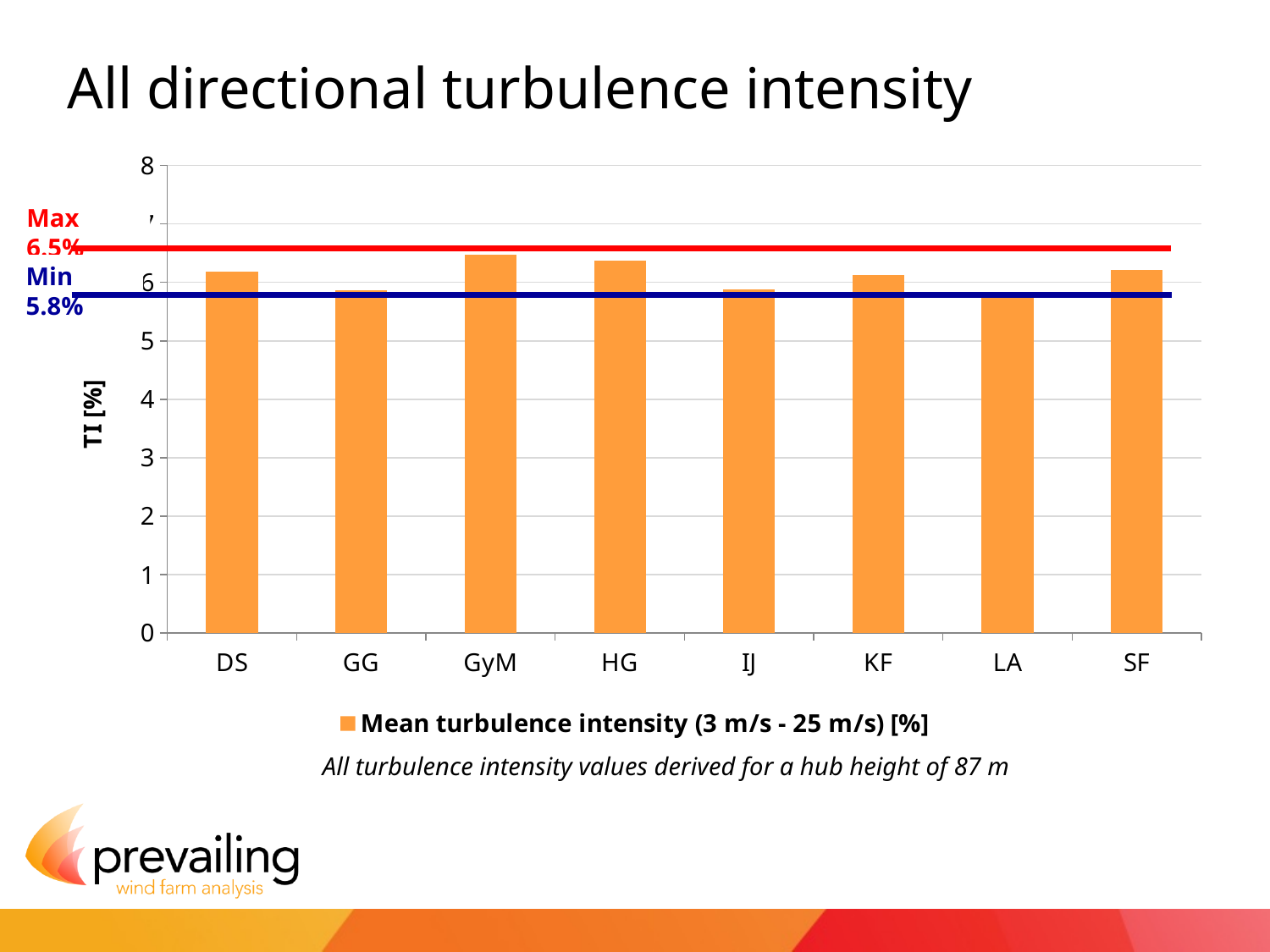
How many series does the chart's legend list? 1 Is the value for LA greater or less than 6? less What kind of chart is shown on the slide? bar chart Is the value for HG greater or less than 6? greater What value is marked by the red Max line on the chart? 6.5% How many categories are shown on the x axis of the chart? 8 Which has the larger value, HG or IJ? HG Is the value for DS greater or less than 6? greater What is the legend entry for the orange bars? Mean turbulence intensity (3 m/s - 25 m/s) [%] Which has the larger value, GyM or GG? GyM